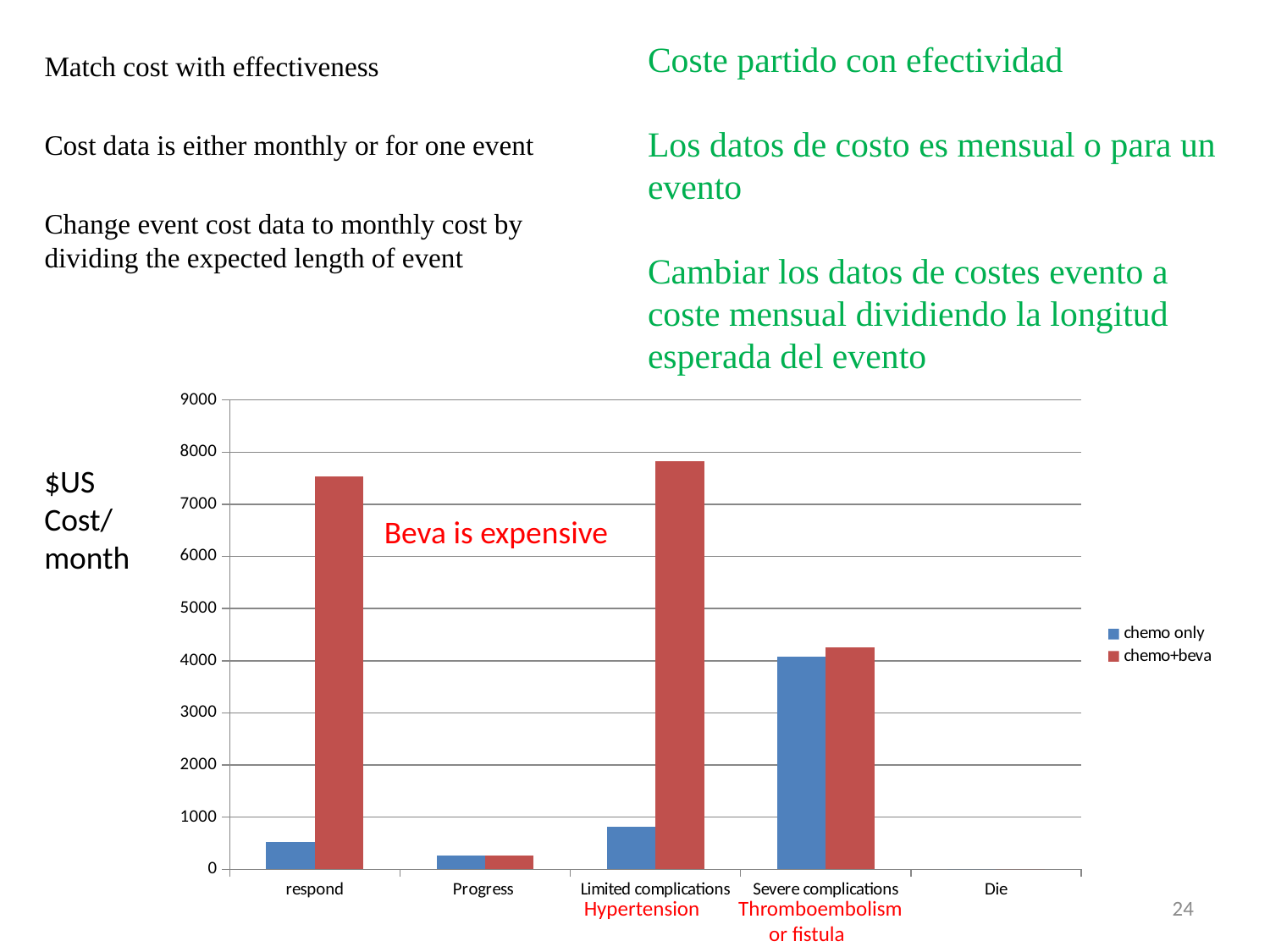
How many series does the chart legend list? 2 For the respond category, which series has the larger value, chemo only or chemo+beva? chemo+beva Is the chemo+beva value for Limited complications greater or less than 8000? less What kind of chart is shown on the slide? bar chart Is the chemo+beva value for respond greater or less than 7000? greater Which category has the highest chemo+beva value? Limited complications What is the label on the y axis of the chart? $US Cost/month Is the chemo only value for respond greater or less than 1000? less Which series is shown in red in the chart? chemo+beva How many categories are shown on the x axis of the chart? 5 Which category has the highest chemo only value? Severe complications